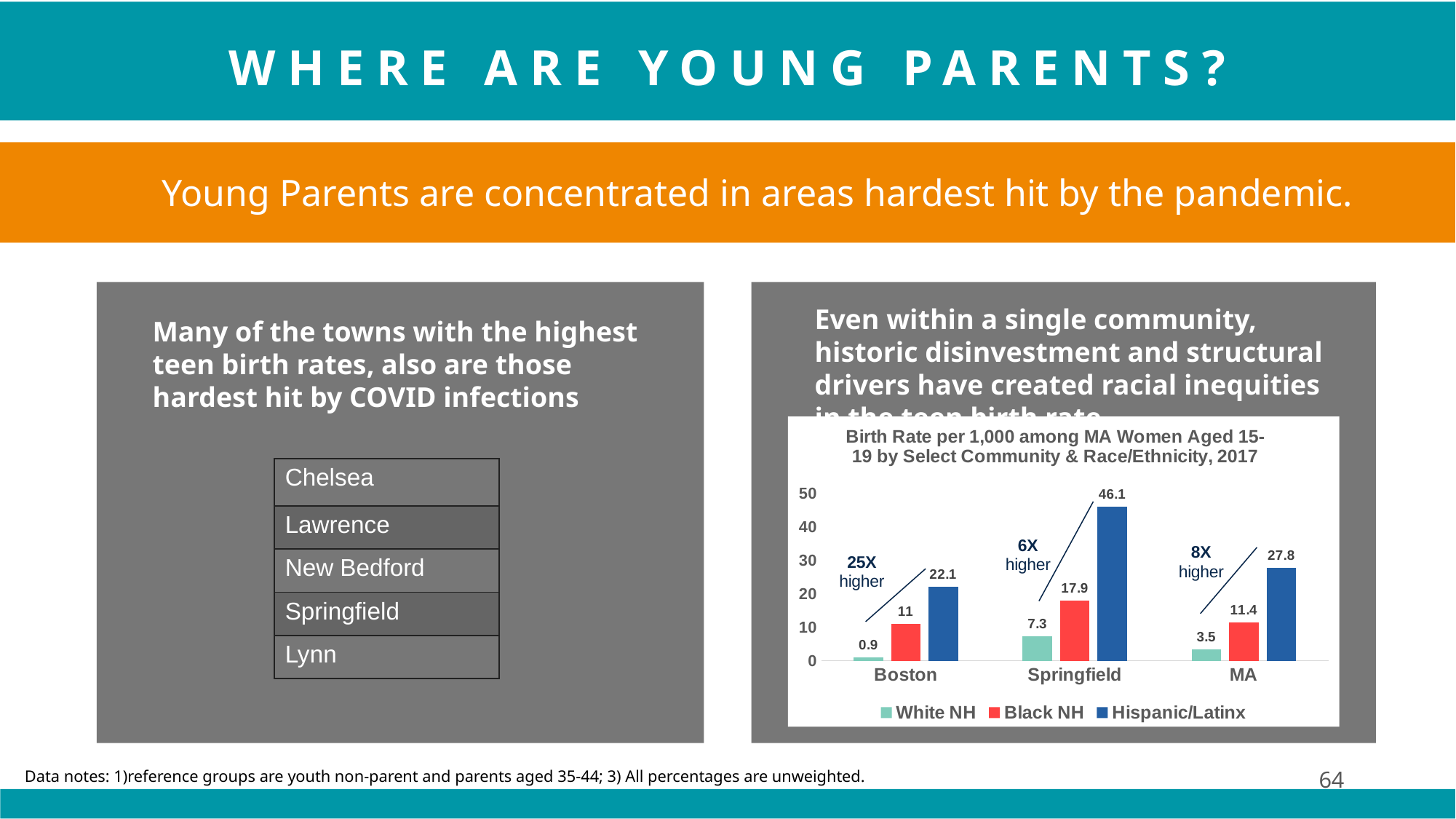
What is the birth rate for White NH women in Boston? 0.9 Which community has the highest Hispanic/Latinx birth rate? Springfield Which community has the lowest White NH birth rate? Boston What is the difference between the Hispanic/Latinx and White NH birth rates in Springfield? 38.8 How many series does the chart legend list? 3 Which is larger, the Black NH birth rate in Springfield or the Hispanic/Latinx birth rate in Boston? Black NH birth rate in Springfield How many communities are shown on the x axis of the chart? 3 What is the birth rate for Black NH women in MA? 11.4 What is the title of the chart? Birth Rate per 1,000 among MA Women Aged 15-19 by Select Community & Race/Ethnicity, 2017 What is the difference between the Black NH birth rates in Springfield and Boston? 6.9 What is the birth rate for Hispanic/Latinx women in Springfield? 46.1 What kind of chart is shown on the slide? Bar chart